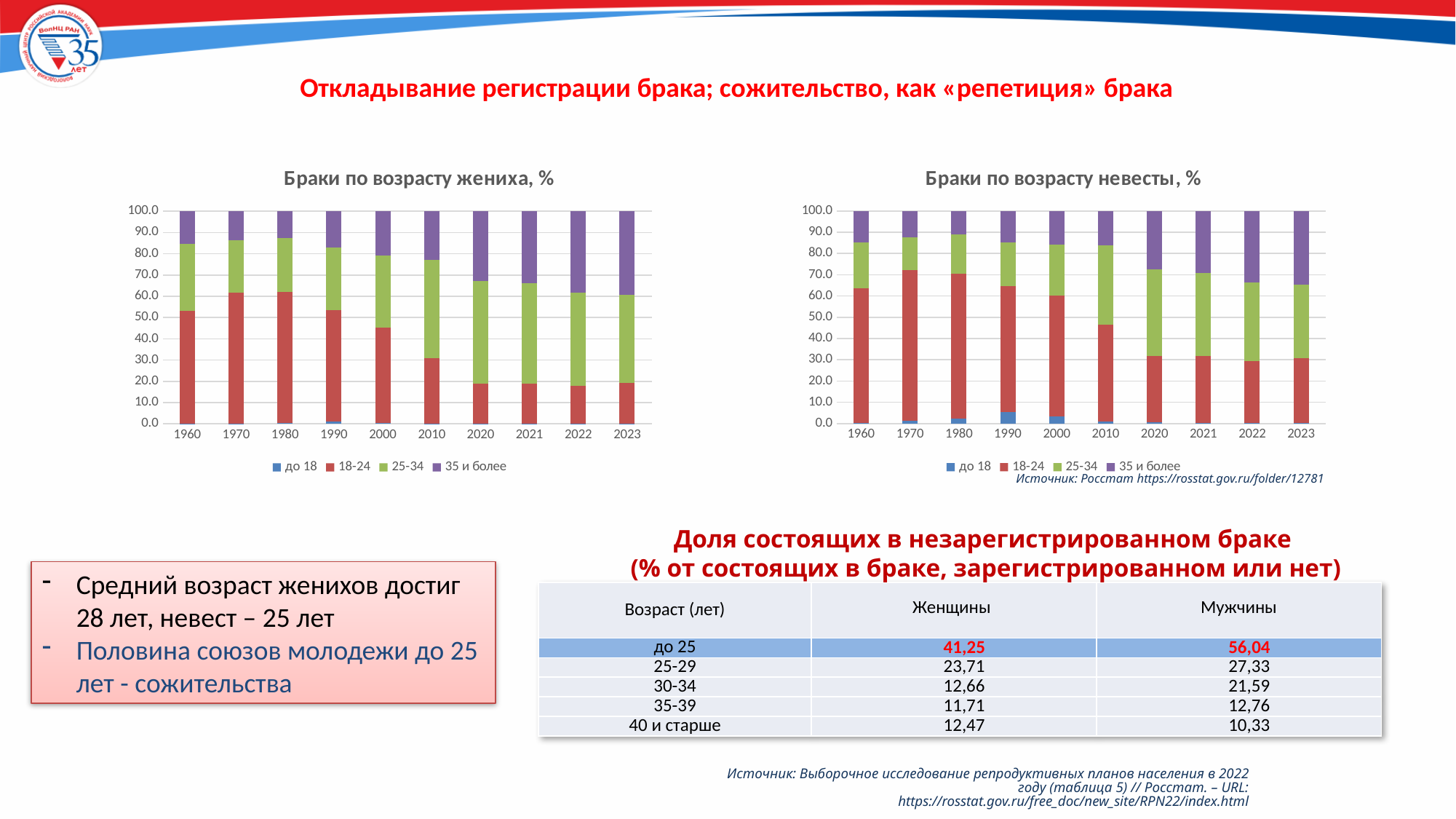
In the chart titled "Браки по возрасту невесты, %", is the value of the 18-24 segment for 1970 greater or less than 60? greater How many years are shown on the x axis of the chart titled "Браки по возрасту невесты, %"? 10 In the chart titled "Браки по возрасту жениха, %", what is the total height of the stacked bar for 2023? 100.0 In the chart titled "Браки по возрасту невесты, %", is the value of the 18-24 segment for 2010 greater or less than 50? less How many series does the legend of the chart titled "Браки по возрасту жениха, %" list? 4 In the chart titled "Браки по возрасту невесты, %", which year has the larger "35 и более" segment: 1960 or 2023? 2023 In the chart titled "Браки по возрасту жениха, %", is the value of the 18-24 segment for 2023 greater or less than 30? less In the chart titled "Браки по возрасту жениха, %", which year has the larger 18-24 segment: 1970 or 2023? 1970 In the chart titled "Браки по возрасту жениха, %", does the 18-24 segment generally rise or fall from 1970 to 2023? Fall What kind of chart is the chart titled "Браки по возрасту жениха, %"? Stacked bar chart What is the title of the chart on the right side of the slide? Браки по возрасту невесты, %